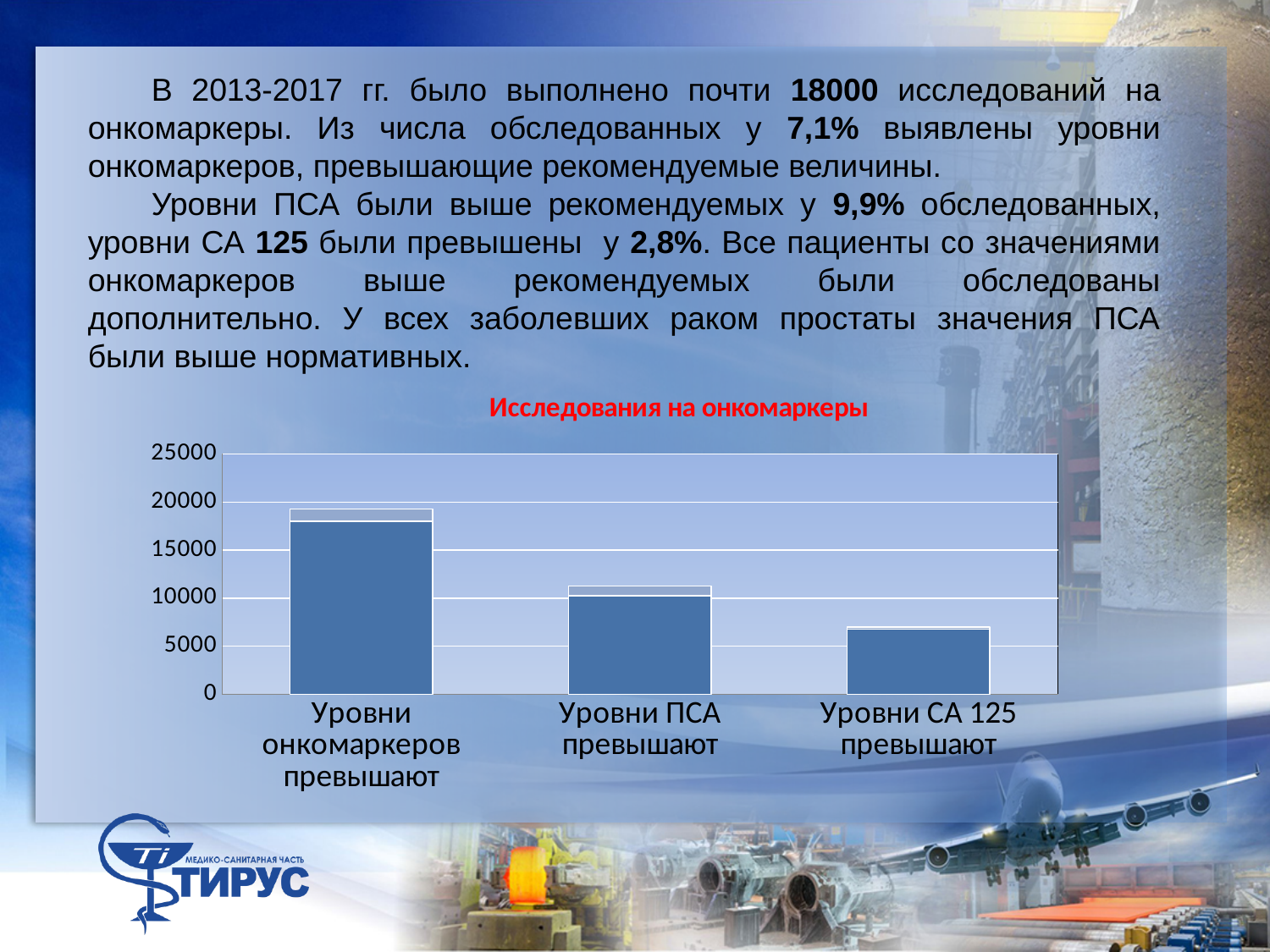
Is the value for 'Уровни онкомаркеров превышают' greater or less than 15000? greater Which is larger: the bar for 'Уровни ПСА превышают' or the bar for 'Уровни СА 125 превышают'? Уровни ПСА превышают How many categories are plotted in the chart? 3 Is the value for 'Уровни СА 125 превышают' greater or less than 10000? less Do the bar values rise or fall from left to right across the categories? fall Which category has the highest bar in the chart? Уровни онкомаркеров превышают Which category has the lowest bar in the chart? Уровни СА 125 превышают What is the highest value shown on the vertical axis of the chart? 25000 Is the value for 'Уровни ПСА превышают' greater or less than 15000? less What is the title of the chart? Исследования на онкомаркеры What kind of chart is shown on the slide? bar chart